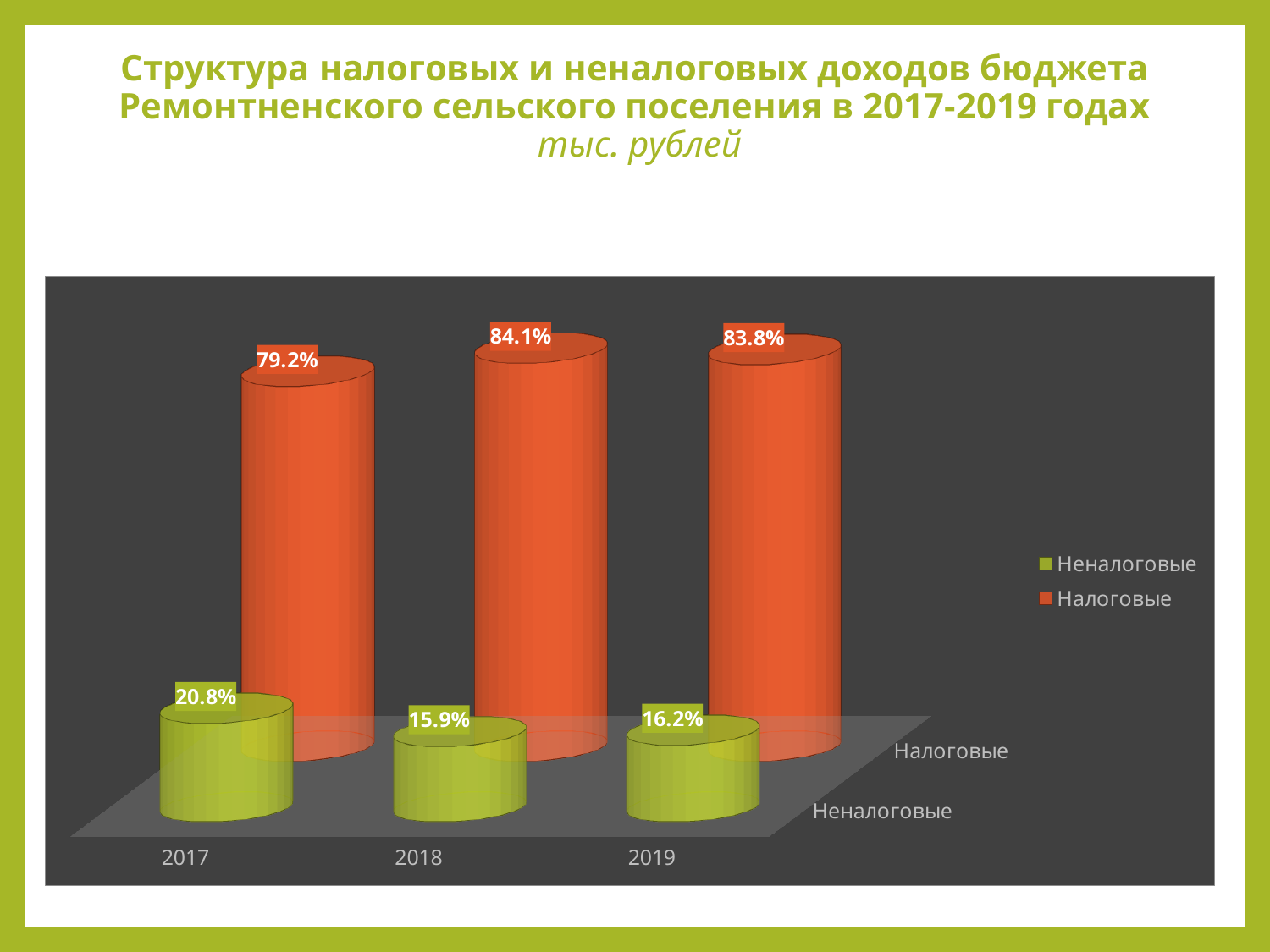
What is the value for Налоговые in 2019? 83.8% What kind of chart is shown on the slide? Bar chart Which colour represents the Неналоговые series? Green What is the difference between the Налоговые share in 2018 and in 2017? 4.9% How many years are shown on the x axis? 3 In which year is the Неналоговые share lowest? 2018 Which is larger: the Неналоговые share in 2017 or in 2019? 2017 What is the value for Налоговые in 2017? 79.2% What is the value for Неналоговые in 2018? 15.9% How many series does the legend list? 2 What is the value for Неналоговые in 2019? 16.2% In which year is the Налоговые share highest? 2018